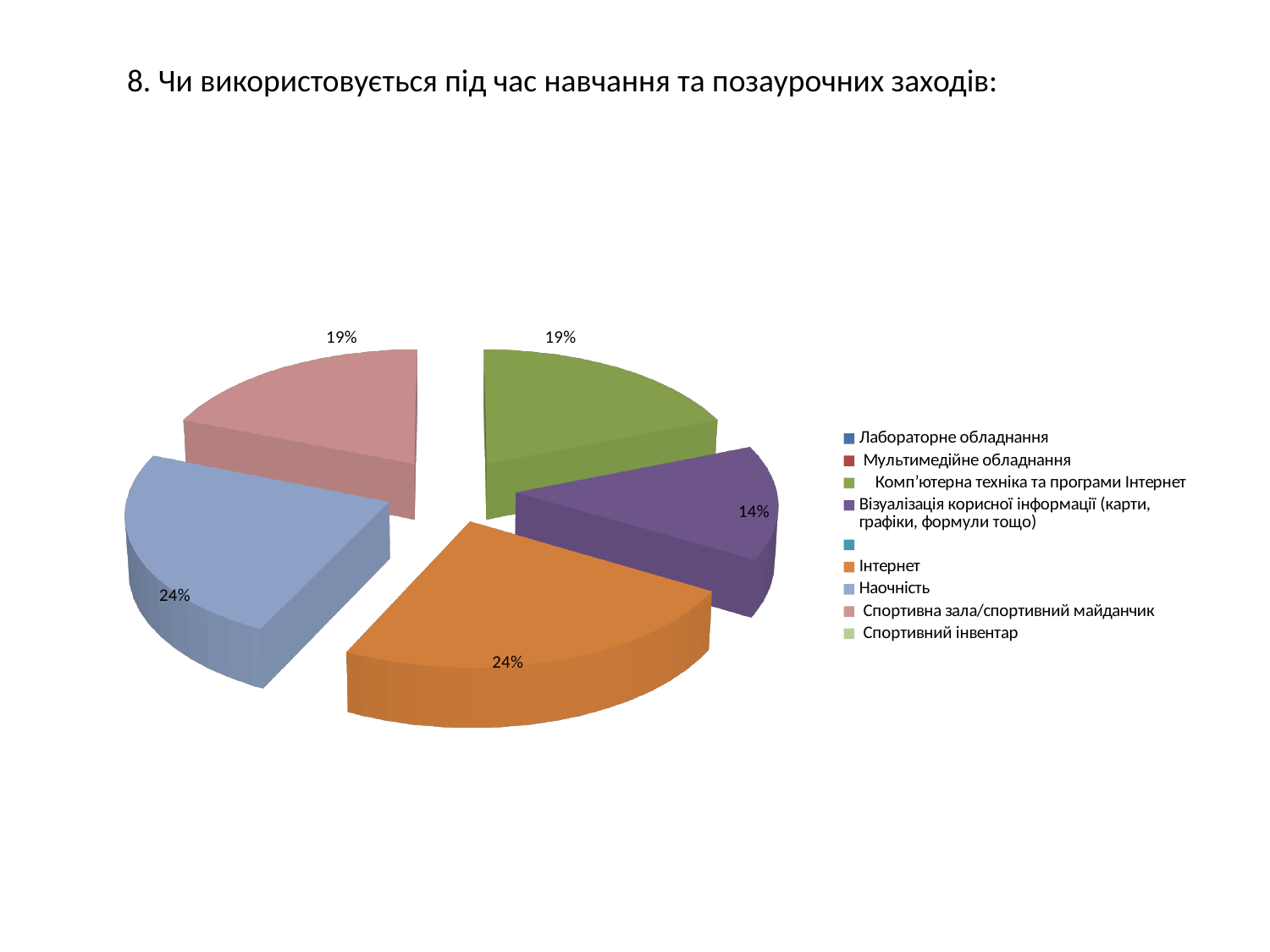
What share of the pie does the Інтернет slice represent? 24% What type of chart is shown on the slide? Pie chart What share does Спортивна зала/спортивний майданчик have in the pie? 19% Which is larger: the share for Інтернет or the share for Візуалізація корисної інформації? Інтернет What percentage is shown for Комп'ютерна техніка та програми Інтернет? 19% What is the difference in percentage points between the Наочність slice and the Візуалізація корисної інформації slice? 10 percentage points What colour is the Інтернет slice in the pie chart? Orange What percentage is shown for Наочність? 24% How many slices with data labels are shown in the pie chart? 5 Which category has the smallest slice of the pie? Візуалізація корисної інформації (карти, графіки, формули тощо) What percentage is shown for Візуалізація корисної інформації (карти, графіки, формули тощо)? 14% What is the title of the slide above the chart? 8. Чи використовується під час навчання та позаурочних заходів: